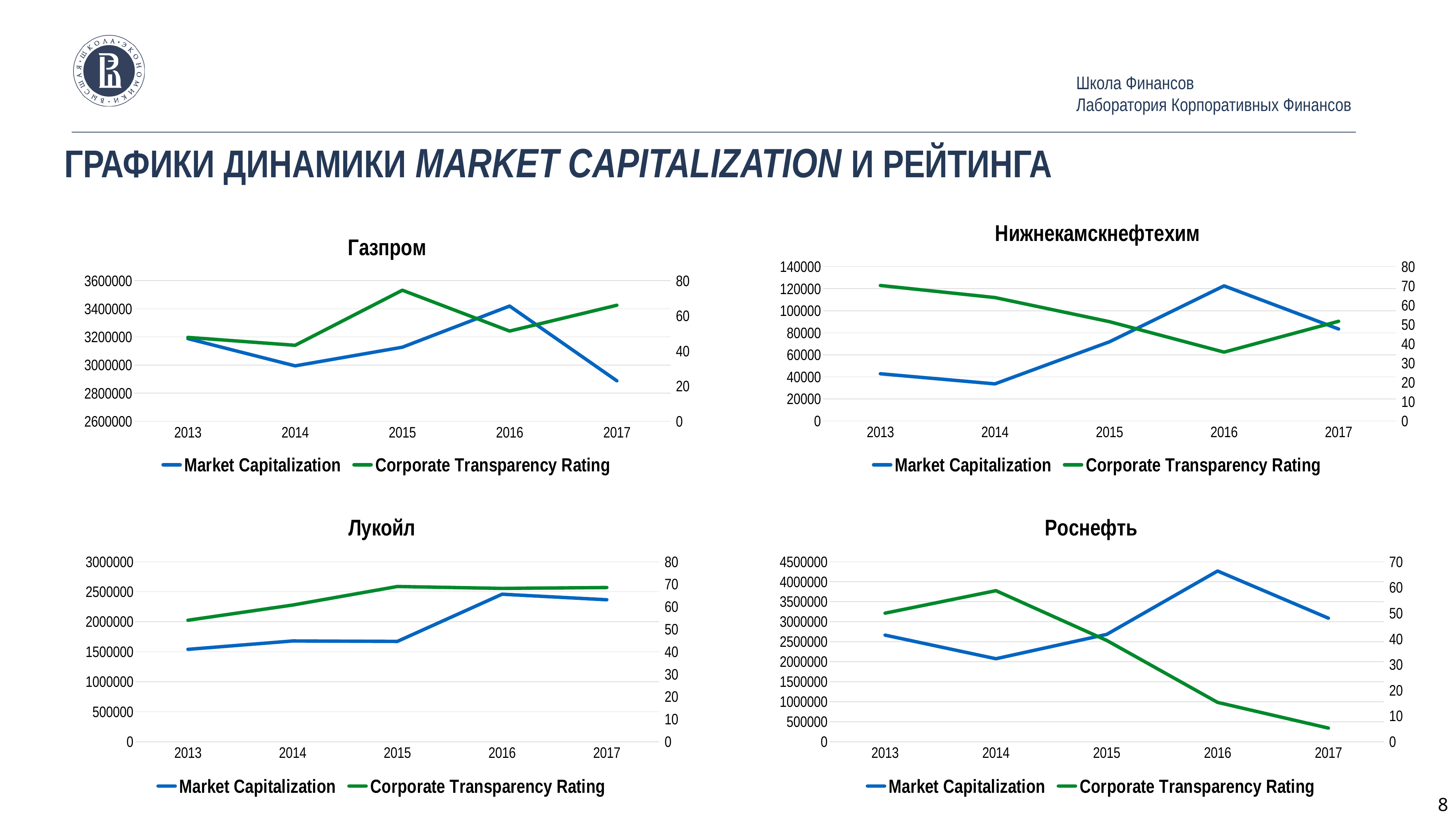
In the Газпром chart, in which year is the Corporate Transparency Rating highest? 2015 Which colour is used for the Corporate Transparency Rating line in the charts? green In the Роснефть chart, is the Market Capitalization value for 2016 greater or less than 4000000? greater In the Лукойл chart, which is larger: Market Capitalization in 2016 or in 2013? 2016 In the Газпром chart, in which year is Market Capitalization highest? 2016 How many series does the legend of the Роснефть chart list? 2 In the Роснефть chart, is the Corporate Transparency Rating for 2017 greater or less than 10? less How many years are plotted on the x axis of the Лукойл chart? 5 In the Роснефть chart, does the Corporate Transparency Rating rise or fall from 2014 to 2017? fall What kind of chart is the Газпром chart? line chart In the Нижнекамскнефтехим chart, in which year is Market Capitalization lowest? 2014 In the Нижнекамскнефтехим chart, in which year is the Corporate Transparency Rating lowest? 2016